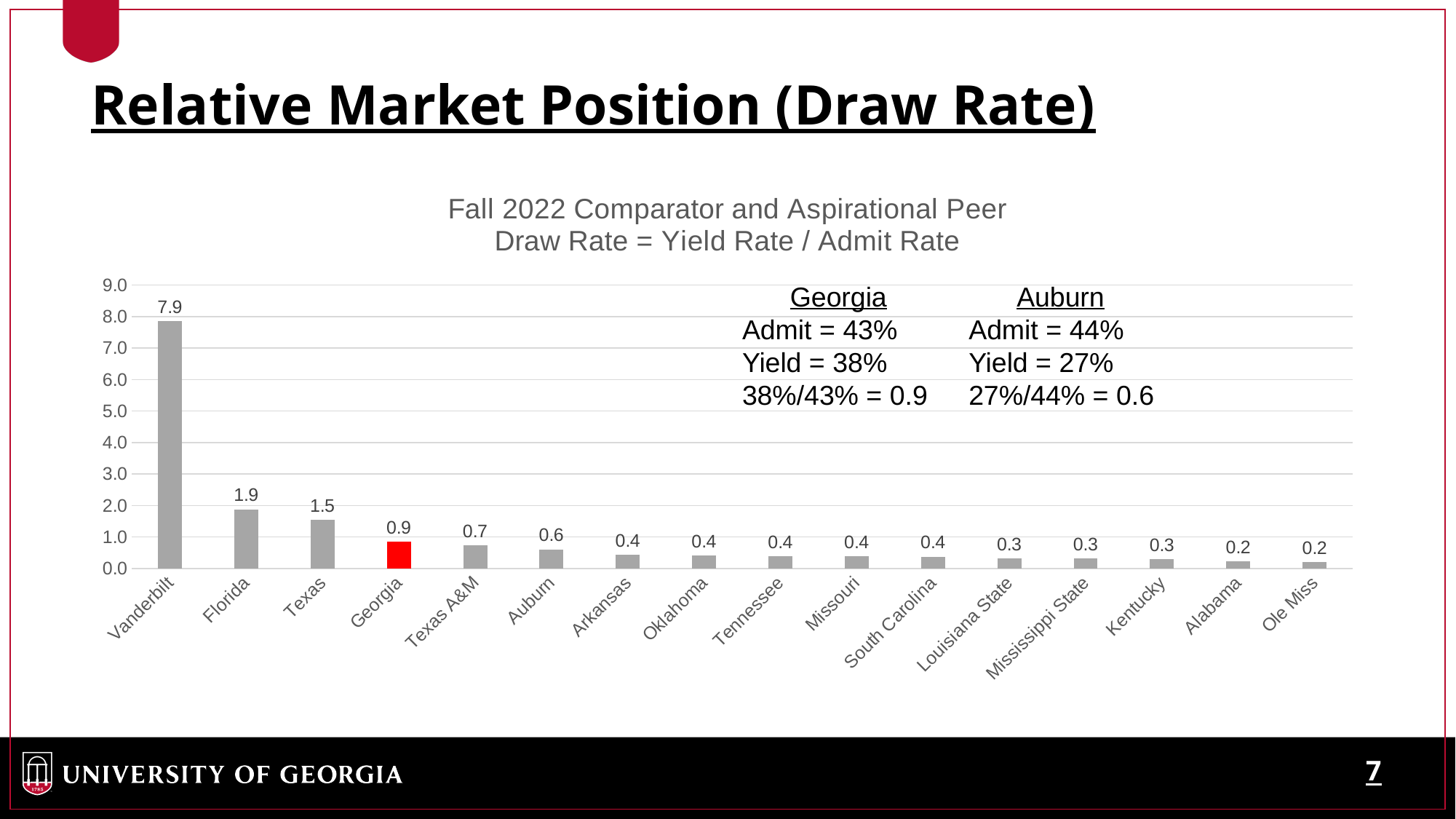
Which university has the highest draw rate? Vanderbilt Which bar on the chart is coloured red? Georgia Is the value for Vanderbilt greater or less than 7.0? greater What is the difference between the draw rates of Vanderbilt and Florida? 6.0 What is the difference between the draw rates of Georgia and Auburn? 0.3 What is the draw rate for Texas A&M? 0.7 Do the draw rates rise or fall from left to right along the x axis? fall Which has a higher draw rate, Florida or Texas? Florida What kind of chart is shown on the slide? bar chart What is the draw rate for Vanderbilt? 7.9 How many universities are shown on the chart? 16 What is the draw rate for Georgia? 0.9